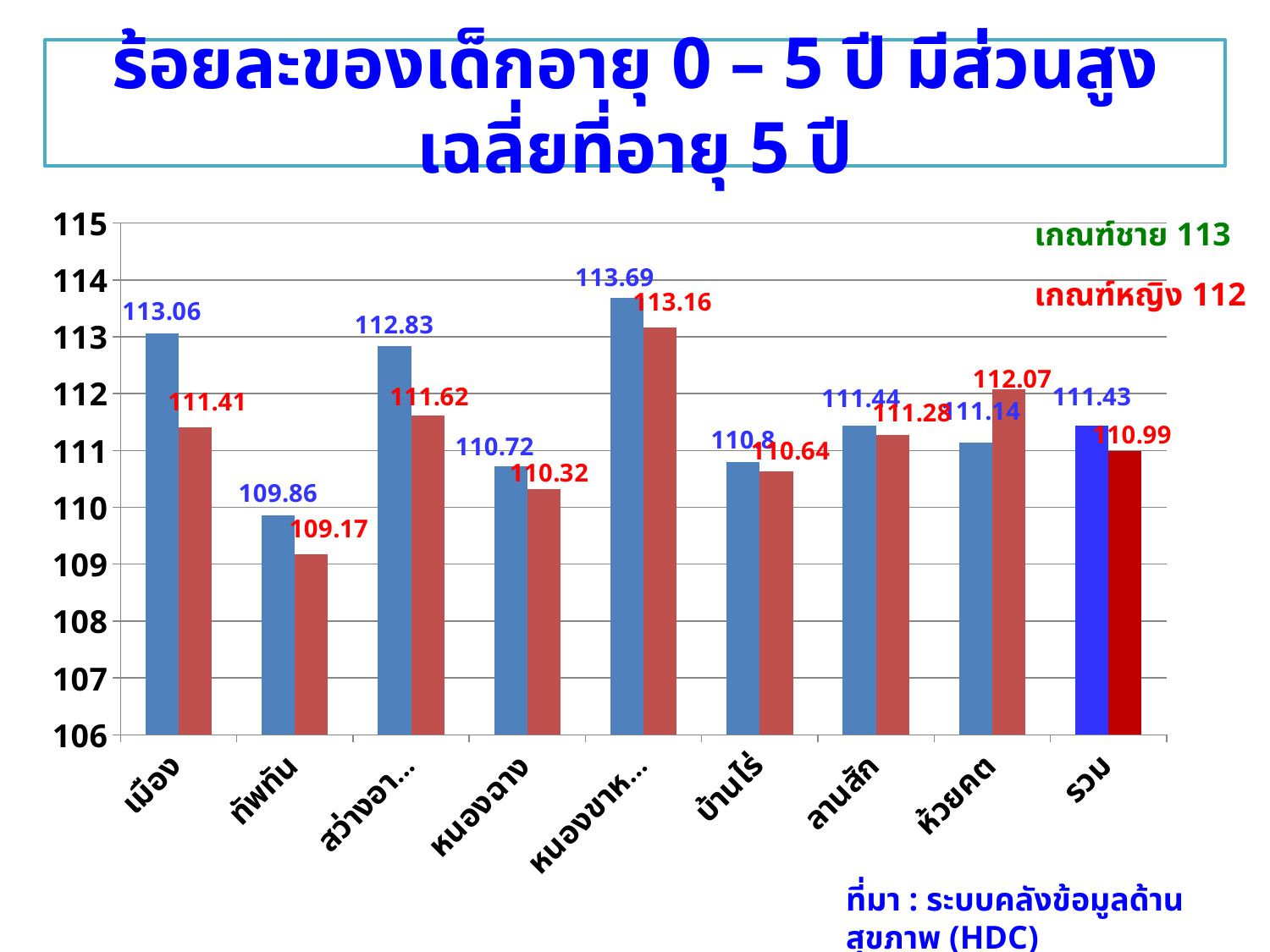
What is the value of the blue bar for รวม? 111.43 What value is given for เกณฑ์ชาย in the text at the top right of the chart? 113 Which category has the lowest blue bar? ทัพทัน Which category has the highest red bar? หนองขาห... How many categories are shown on the x axis of the chart? 9 What is the value of the blue bar for เมือง? 113.06 What is the difference between the blue bar and the red bar for เมือง? 1.65 For ห้วยคต, which is larger, the blue bar or the red bar? the red bar What is the value of the red bar for ทัพทัน? 109.17 What type of chart is shown on the slide? bar chart Is the value of the blue bar for หนองฉาง greater or less than 111? less What is the value of the red bar for ห้วยคต? 112.07